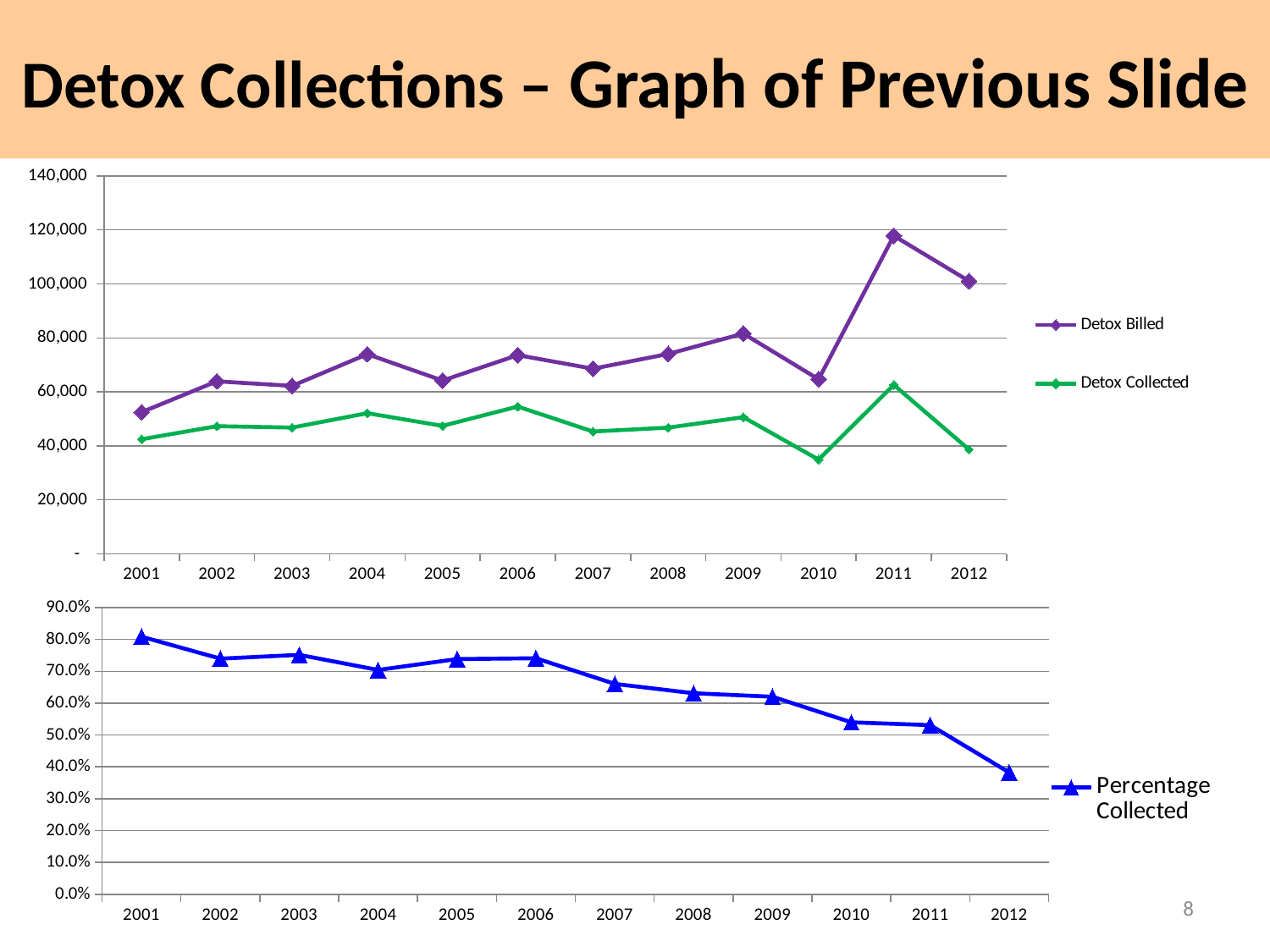
In the top chart, which is larger in 2011: Detox Billed or Detox Collected? Detox Billed In the bottom chart, which year has the lowest Percentage Collected? 2012 In the top chart, is the Detox Collected value for 2010 greater or less than 40,000? less What colour is the Detox Collected line in the top chart? Green How many series does the legend of the top chart list? 2 In the top chart, which year has the highest Detox Billed value? 2011 In the top chart, is the Detox Billed value for 2011 greater or less than 100,000? greater In the top chart, which year has the lowest Detox Collected value? 2010 How many years are plotted along the x axis of the top chart? 12 In the bottom chart, does Percentage Collected generally rise or fall from 2001 to 2012? Fall In the bottom chart, is the Percentage Collected for 2007 greater or less than 70.0%? less What kind of chart is the bottom chart? Line chart